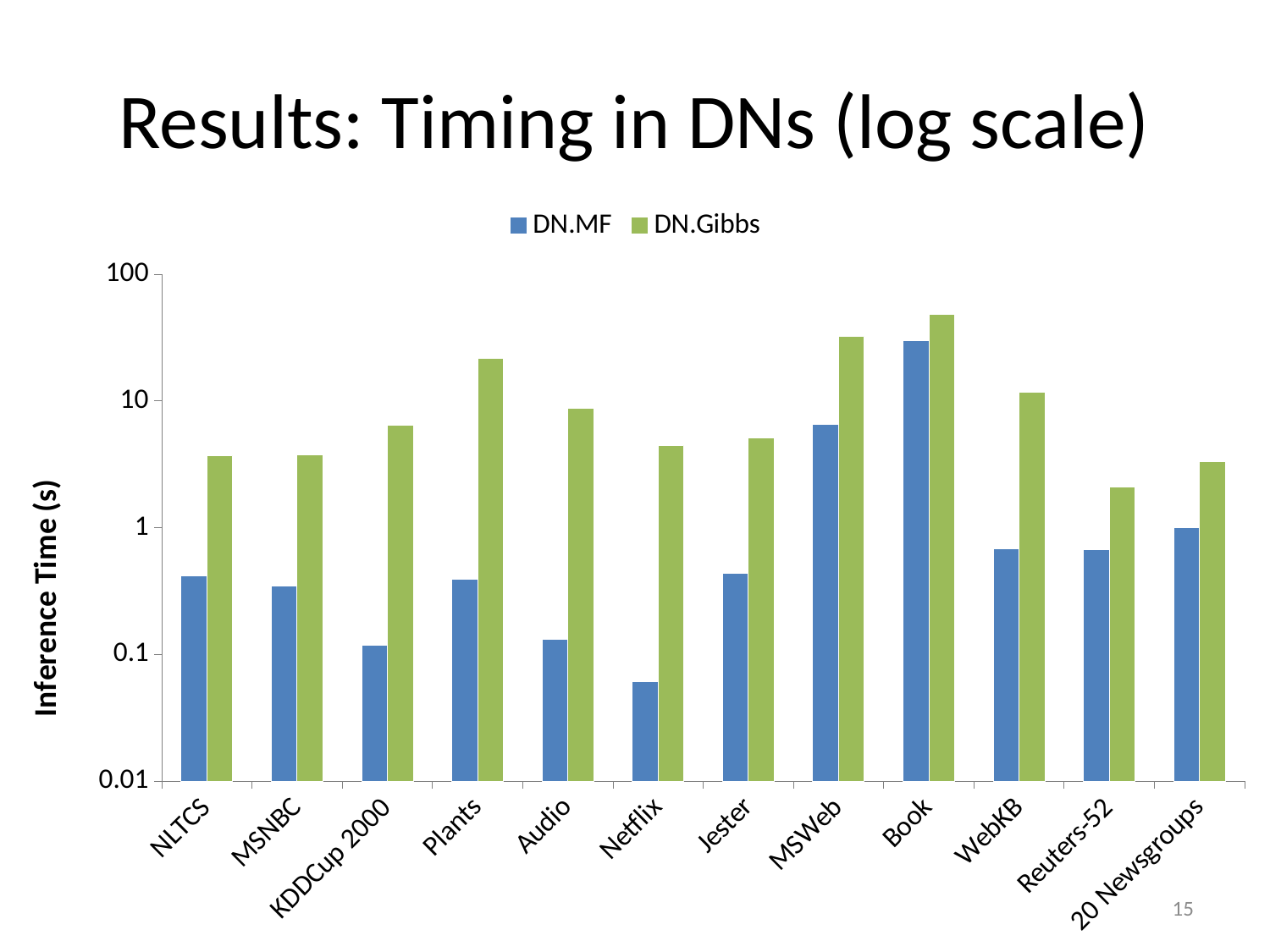
Which dataset has the highest DN.MF inference time? Book Which dataset has the highest DN.Gibbs inference time? Book How many datasets (categories) are shown on the x axis? 12 For Plants, which is larger: the DN.MF or the DN.Gibbs inference time? DN.Gibbs Is the DN.MF inference time for Netflix greater or less than 0.1? less Is the DN.Gibbs inference time for NLTCS greater or less than 1? greater What kind of chart is shown on the slide? bar chart How many series does the legend list? 2 Which dataset has the lowest DN.MF inference time? Netflix Which dataset has the lowest DN.Gibbs inference time? Reuters-52 Is the DN.MF inference time for Book greater or less than 10? greater What is the label of the y axis? Inference Time (s)